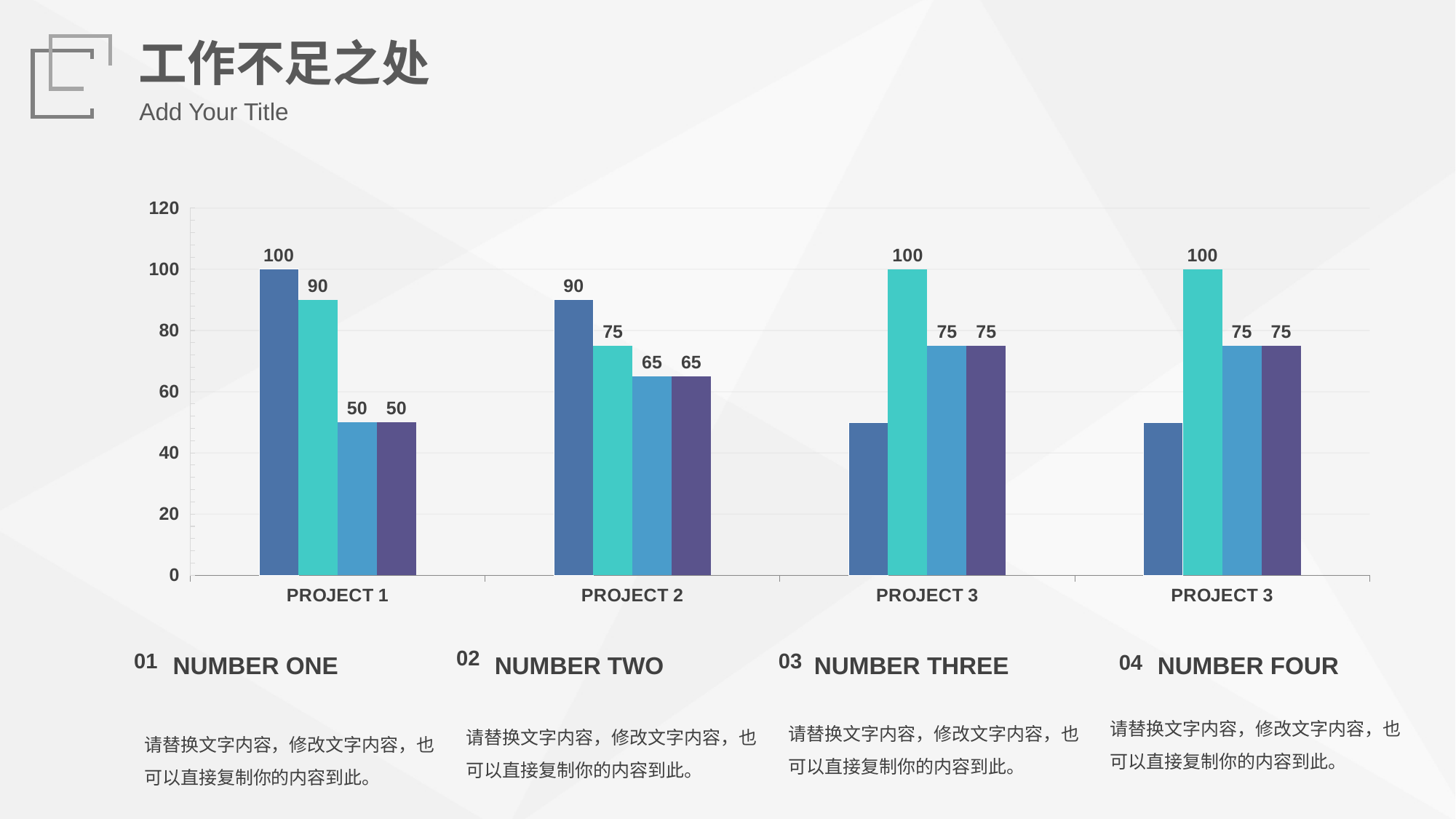
What is the value of the fourth (purple) bar for PROJECT 1? 50 What is the difference between the first bar (90) and the third bar (65) for PROJECT 2? 25 What is the difference between the first bar (100) and the third bar (50) for PROJECT 1? 50 What is the highest value shown on the chart's vertical axis? 120 What kind of chart is shown on the slide? bar chart How many bars are there in each category group of the chart? 4 Is the value of the first (dark blue) bar in the third group greater or less than 60? less Which bar is the highest within the PROJECT 2 group? the first (dark blue) bar, 90 Which is larger: the teal bar for PROJECT 1 or the teal bar for PROJECT 2? PROJECT 1 What is the value of the second (teal) bar for PROJECT 2? 75 How many category groups are shown along the x axis of the chart? 4 What is the value of the first (dark blue) bar for PROJECT 1? 100